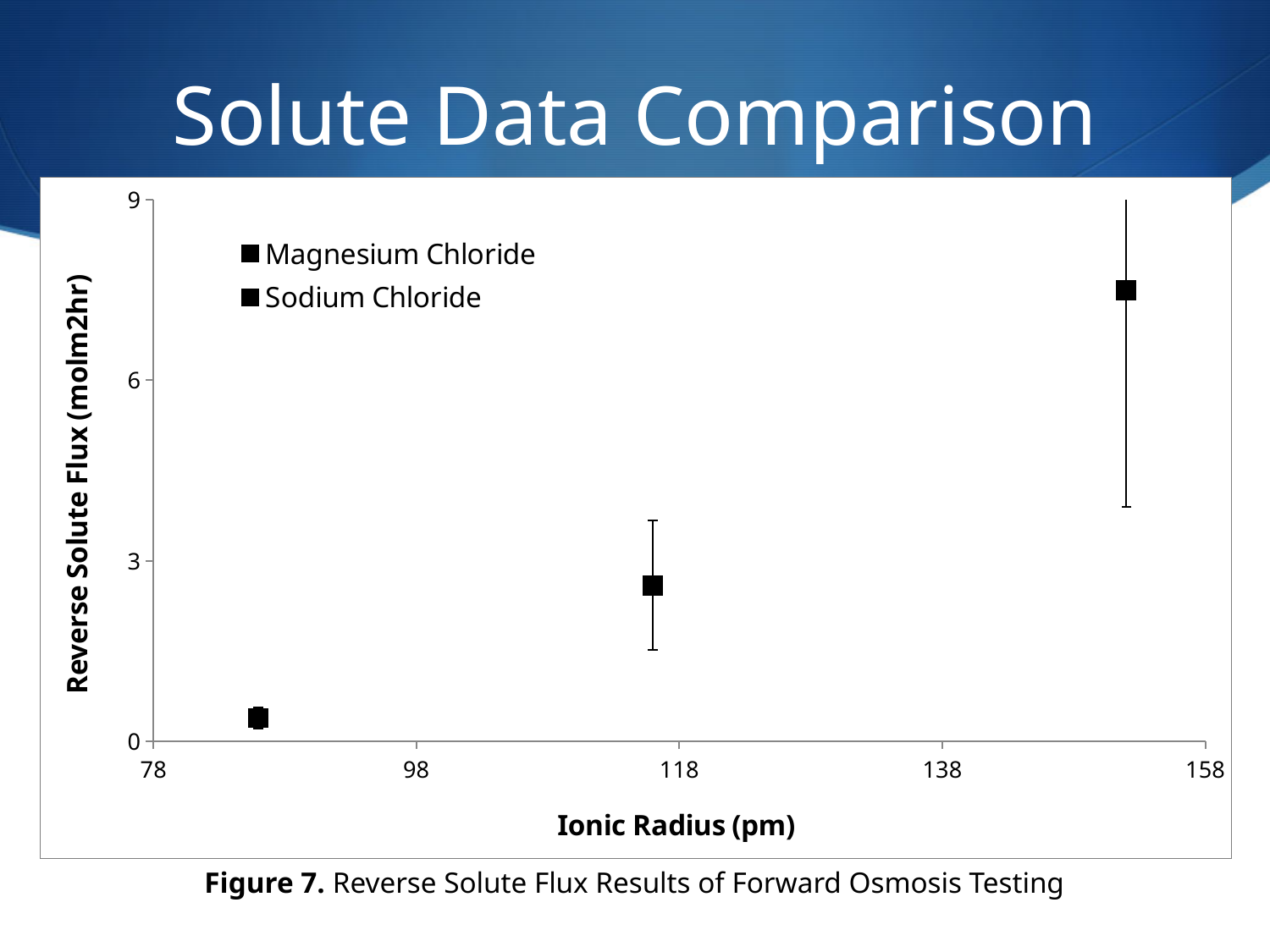
What is the title of the x axis? Ionic Radius (pm) What kind of chart is shown on the slide? scatter chart What are the two series named in the legend? Magnesium Chloride and Sodium Chloride Do the reverse solute flux values rise or fall as ionic radius increases along the x axis? rise Is the reverse solute flux of the rightmost data point greater or less than 6? greater Which has a larger reverse solute flux, the middle data point or the leftmost data point? the middle data point Which data point has the lowest reverse solute flux: the leftmost, middle, or rightmost? leftmost Which data point has the highest reverse solute flux: the leftmost, middle, or rightmost? rightmost How many series does the legend list? 2 Is the reverse solute flux of the middle data point greater or less than 3? less How many data points are plotted on the chart? 3 Is the reverse solute flux of the leftmost data point greater or less than 3? less